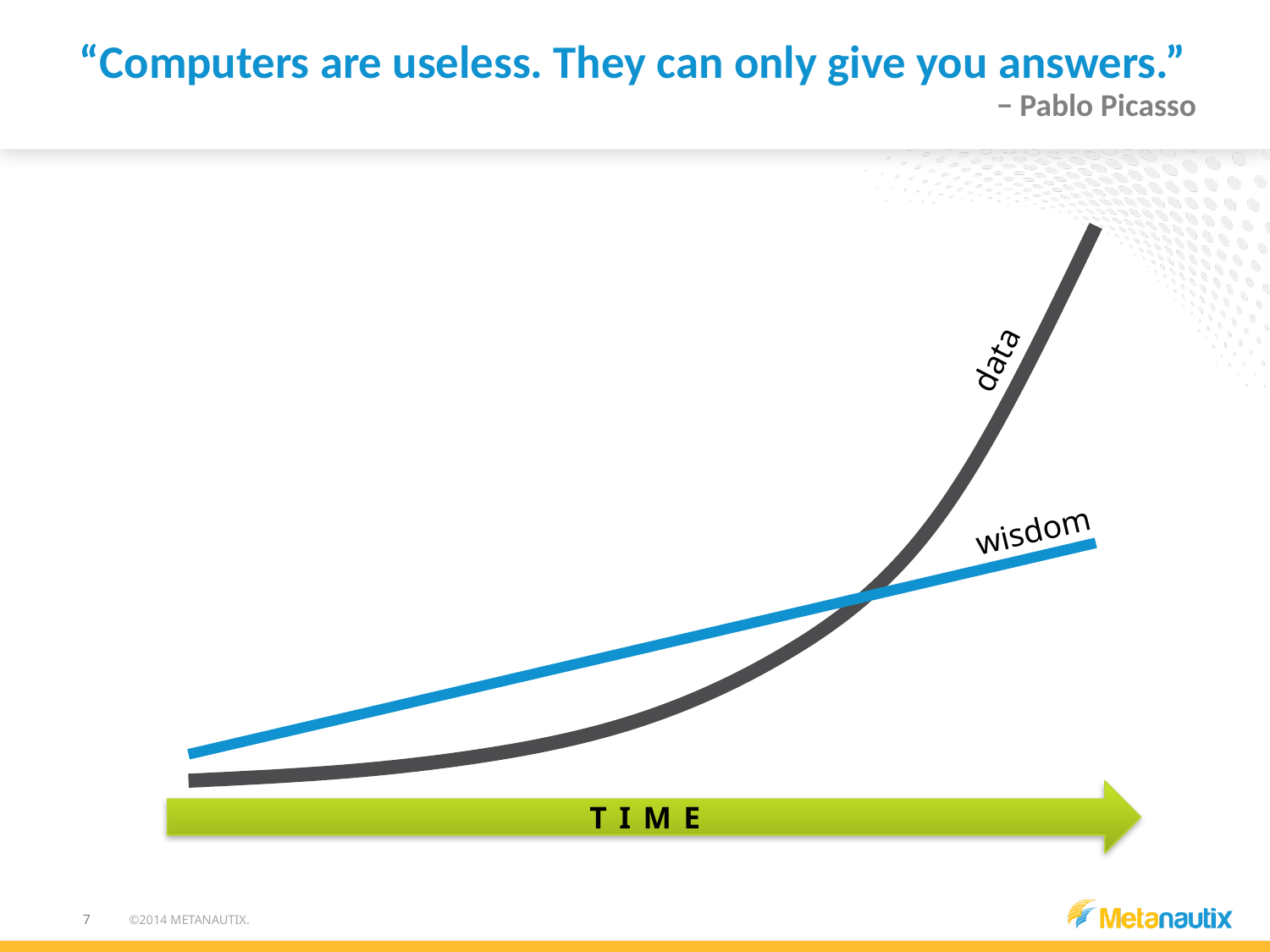
How many lines are plotted on the chart? 2 What is the label on the horizontal axis of the chart? TIME At the right end of the chart, which line is higher, "data" or "wisdom"? data Which line on the chart rises more steeply toward the right end? data Does the line labelled "data" rise or fall over time? rise What kind of chart is shown on the slide? line chart What are the two lines on the chart labelled? data and wisdom Which line on the chart is drawn in blue? wisdom Does the line labelled "wisdom" rise or fall over time? rise At the left end of the chart, which line is higher, "data" or "wisdom"? wisdom